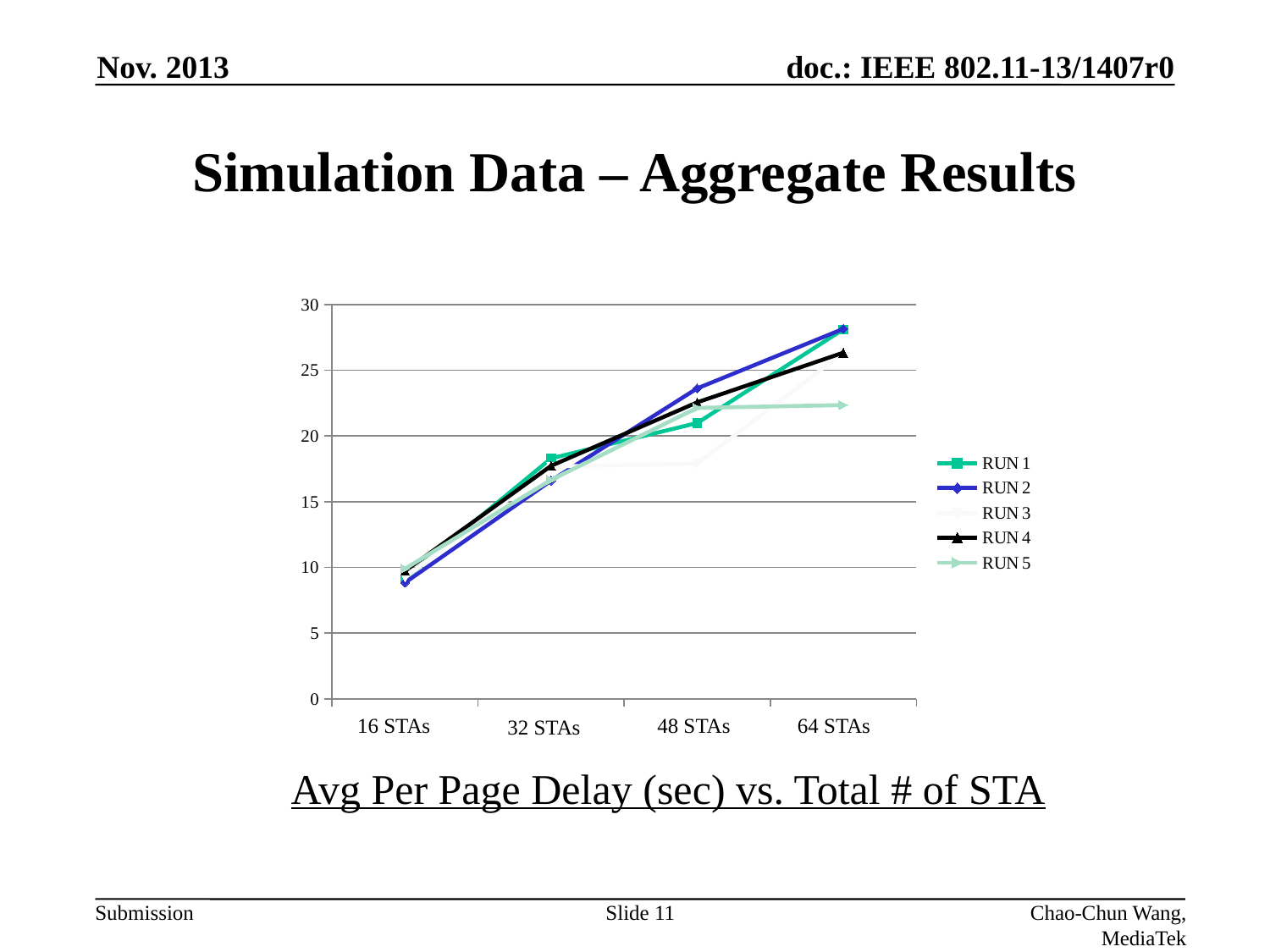
How many categories are shown on the x axis? 4 Which series has the lowest value at 64 STAs? RUN 5 What is the label of the last category on the x axis? 64 STAs Is the value for RUN 2 at 48 STAs greater or less than 20? greater What is the caption below the chart? Avg Per Page Delay (sec) vs. Total # of STA Is the value for RUN 5 at 64 STAs greater or less than 25? less Is the value for RUN 1 at 64 STAs greater or less than 25? greater What kind of chart is shown on the slide? line chart At 64 STAs, which is larger: the value for RUN 1 or the value for RUN 5? RUN 1 Do the values for RUN 1 rise or fall as the number of STAs increases? rise How many series does the legend list? 5